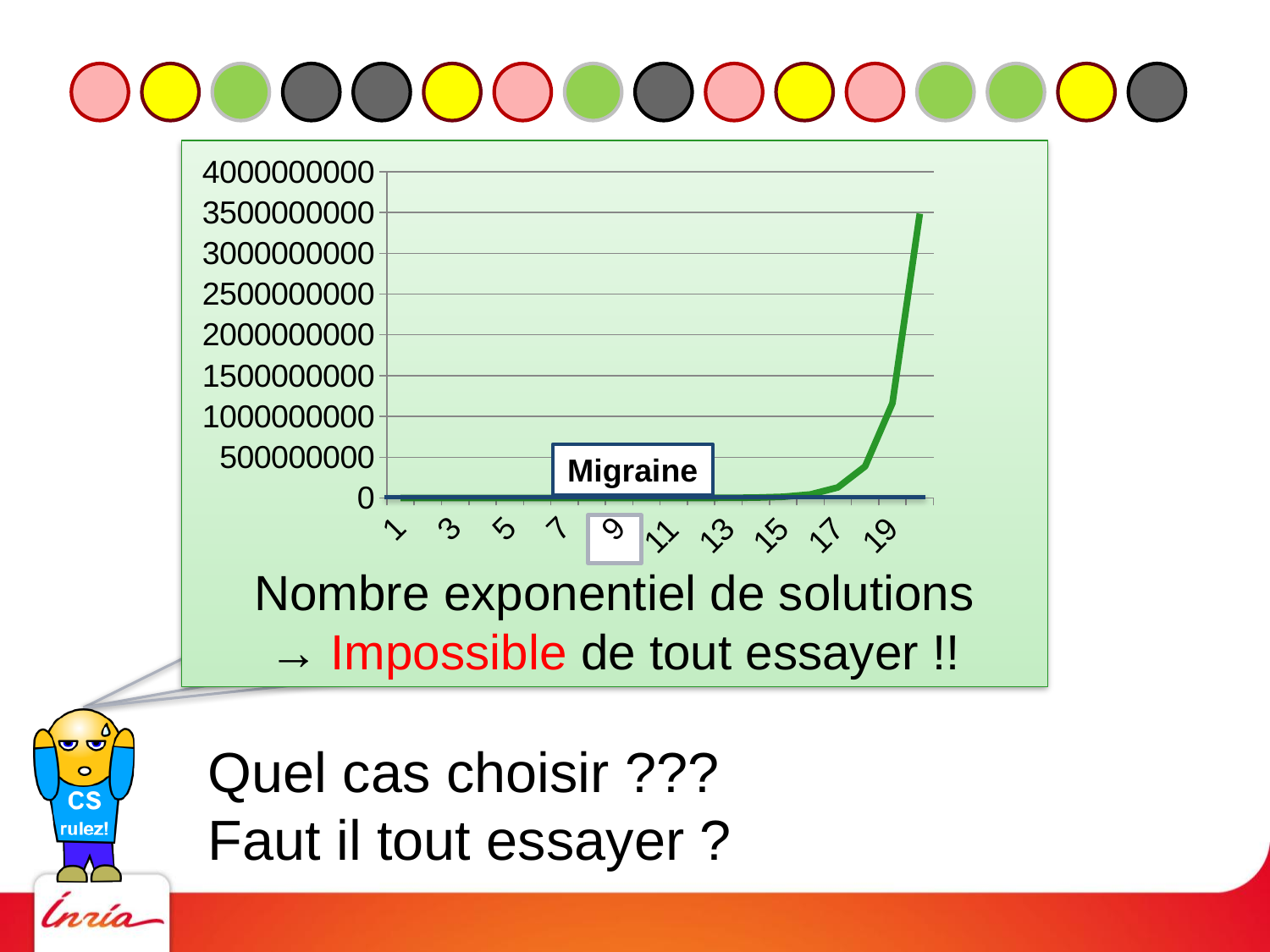
Do the values on the chart rise or fall as the x axis increases? rise What kind of chart is shown on the slide? line chart Which of the two values is larger: the value at x = 19 or the value at x = 11? x = 19 How many labels are printed along the chart's x axis? 10 Is the highest value reached by the line greater or less than 3000000000? greater Where along the x axis does the line reach its highest value: at the left end or the right end? right end Is the value at x = 1 greater or less than 500000000? less What is the lowest value shown on the chart's y axis? 0 Is the value at x = 17 greater or less than 500000000? less What is the highest value shown on the chart's y axis? 4000000000